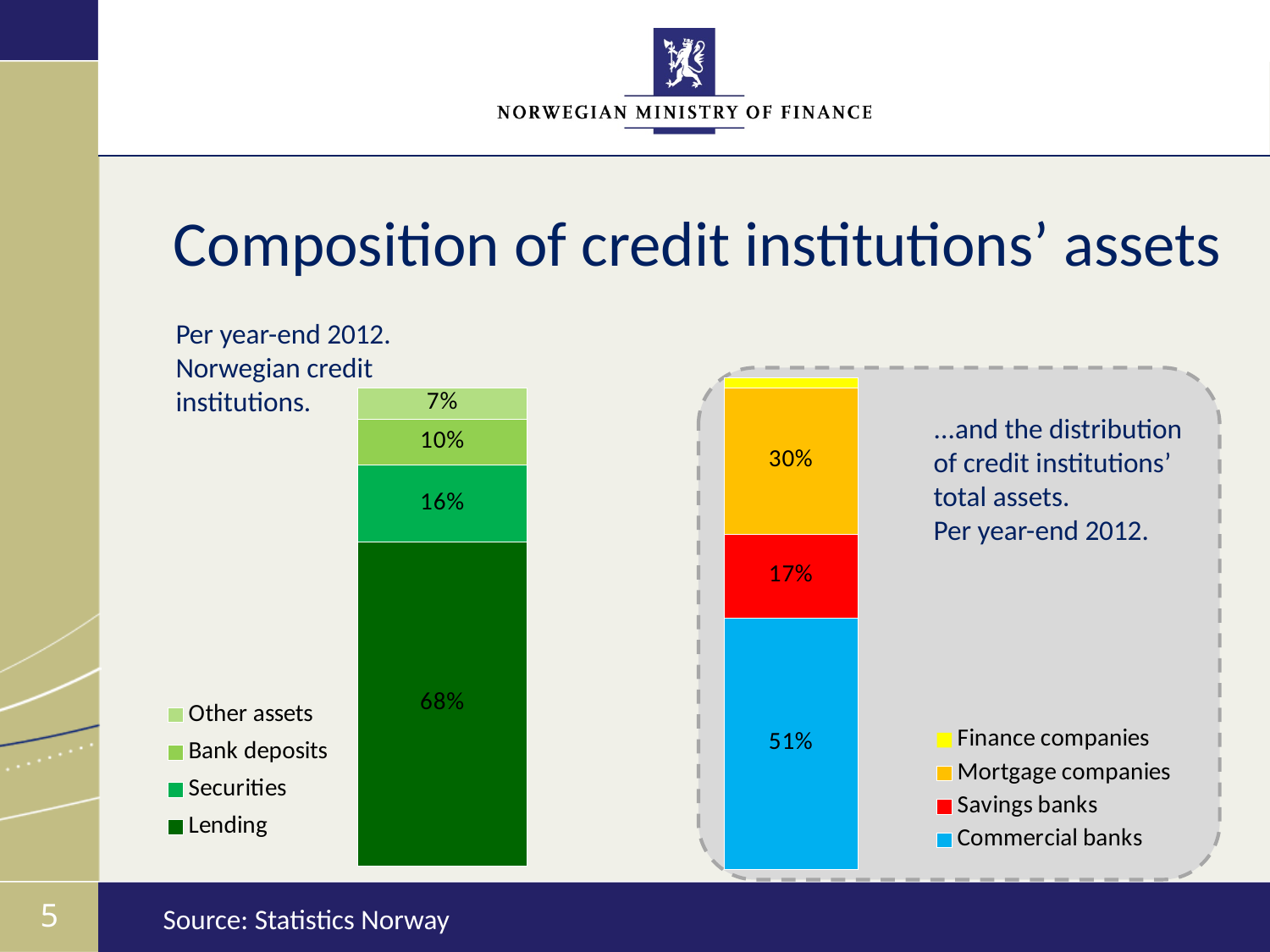
In the left chart, what percentage is shown for Other assets? 7% In the right chart, what share of total assets do Commercial banks hold? 51% In the left chart, what is the difference between the Lending share and the Securities share? 52% In the left chart, which asset category has the largest share? Lending In the left chart, what percentage is shown for Securities? 16% In the right chart, which type of institution has the smallest share of total assets? Finance companies In the right chart, what share of total assets do Mortgage companies hold? 30% In the right chart, what share of total assets do Savings banks hold? 17% How many series does the legend of the right chart list? 4 In the right chart, which is larger: the share for Mortgage companies or the share for Savings banks? Mortgage companies In the left chart, what share of credit institutions' assets is Lending? 68% In the left chart, what percentage is shown for Bank deposits? 10%